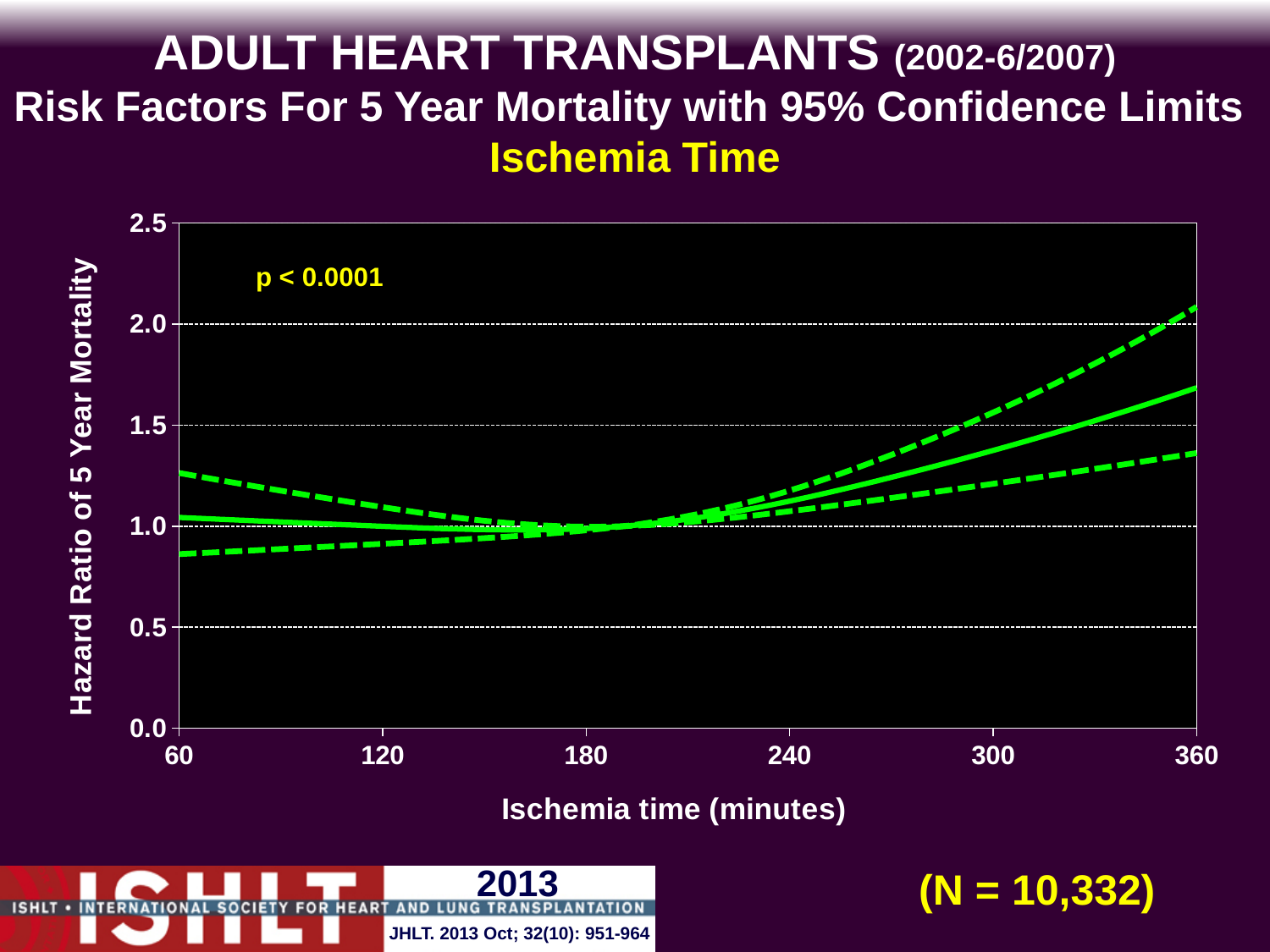
Is the lower dashed confidence limit at 360 minutes greater or less than 1.5? less Is the upper dashed confidence limit at 360 minutes greater or less than 2.0? greater Is the solid hazard ratio line at 360 minutes greater or less than 1.5? greater What p-value is printed on the chart? p < 0.0001 How many tick labels are shown on the x axis? 6 Does the solid hazard ratio line rise or fall between 180 and 360 minutes of ischemia time? rise What is the label of the y axis? Hazard Ratio of 5 Year Mortality What kind of chart is shown on the slide? line chart How many lines are plotted on the chart? 3